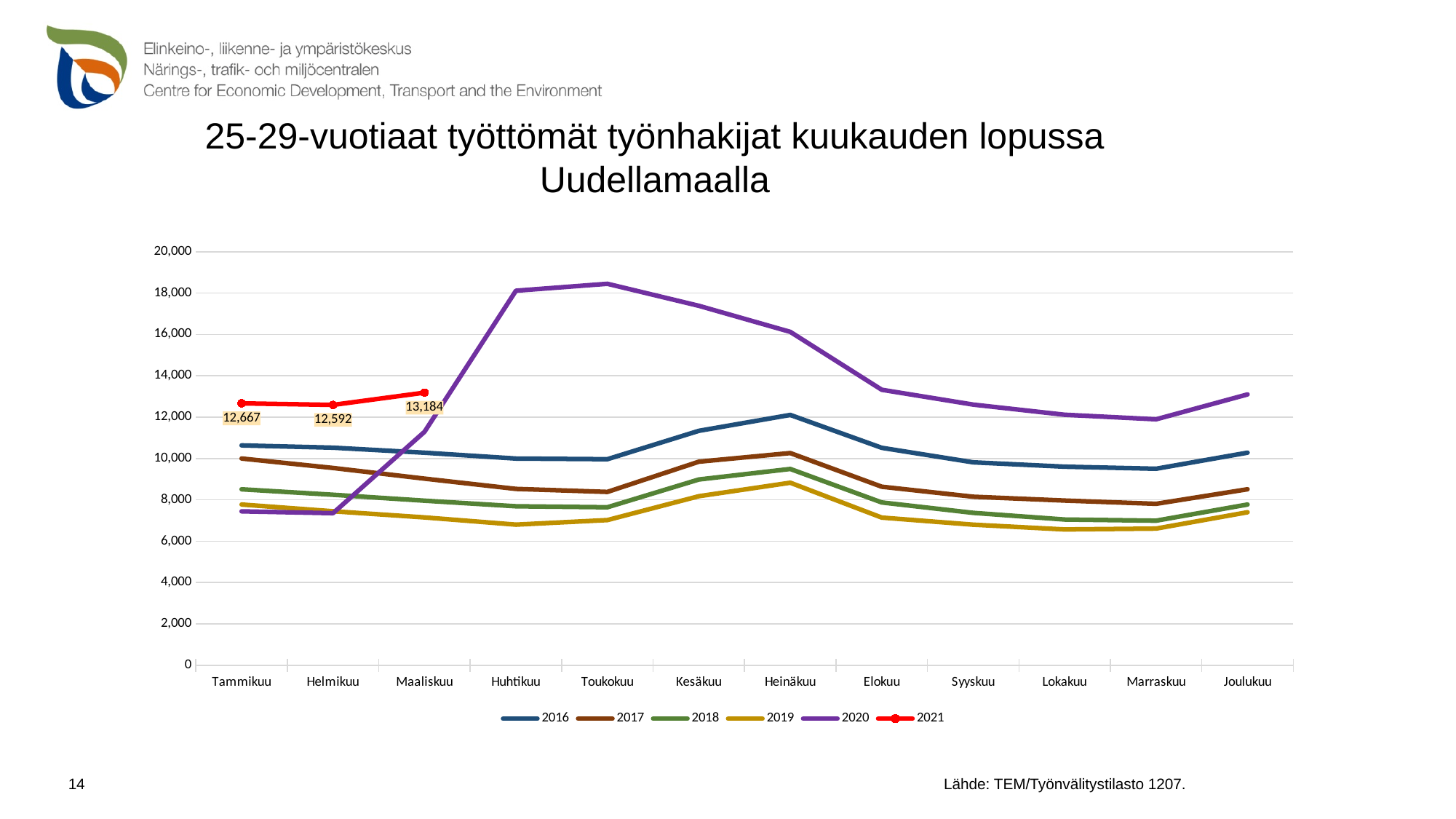
How much higher is the 2021 value in Maaliskuu than in Helmikuu? 592 Which month has the highest value for the 2021 series? Maaliskuu What is the value for 2021 in Maaliskuu? 13,184 How many series does the legend list? 6 What is the value for 2021 in Tammikuu? 12,667 How many months are shown on the x axis? 12 Which series is drawn in red with circular markers? 2021 Is the value for 2020 in Toukokuu greater or less than 18,000? greater What is the value for 2021 in Helmikuu? 12,592 What kind of chart is shown on the slide? Line chart Which series has the higher value in Huhtikuu, 2020 or 2016? 2020 What is the difference between the 2021 values for Tammikuu and Helmikuu? 75